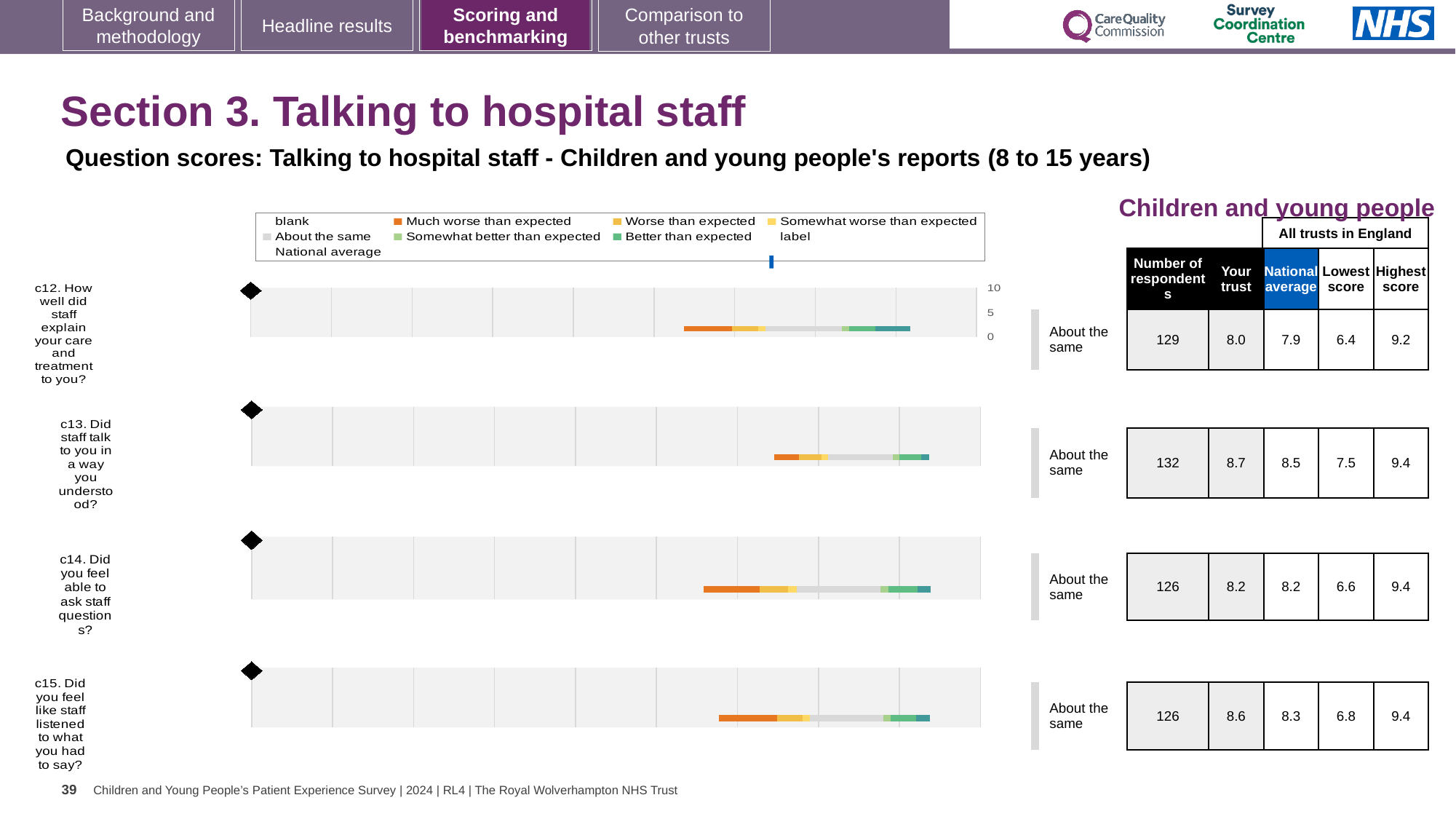
Which question has the lowest 'Your trust' score on this slide? c12 How many respondents are shown for question c12 (How well did staff explain your care and treatment to you?)? 129 What kind of chart is used to show each question's benchmarking result? Bar chart What is the lowest score across all trusts in England shown for question c14 (Did you feel able to ask staff questions?)? 6.6 For question c15, which is larger: the 'Your trust' score or the national average? Your trust What benchmark category is shown for question c14 (Did you feel able to ask staff questions?)? About the same For question c13 (Did staff talk to you in a way you understood?), what is the 'Your trust' score shown? 8.7 For question c13, what is the difference between the 'Your trust' score and the national average? 0.2 Which question has the highest 'Your trust' score on this slide? c13 What is the highest score across all trusts in England shown for question c12? 9.2 For question c15 (Did you feel like staff listened to what you had to say?), what is the national average score shown? 8.3 How many question charts are shown on this slide? 4